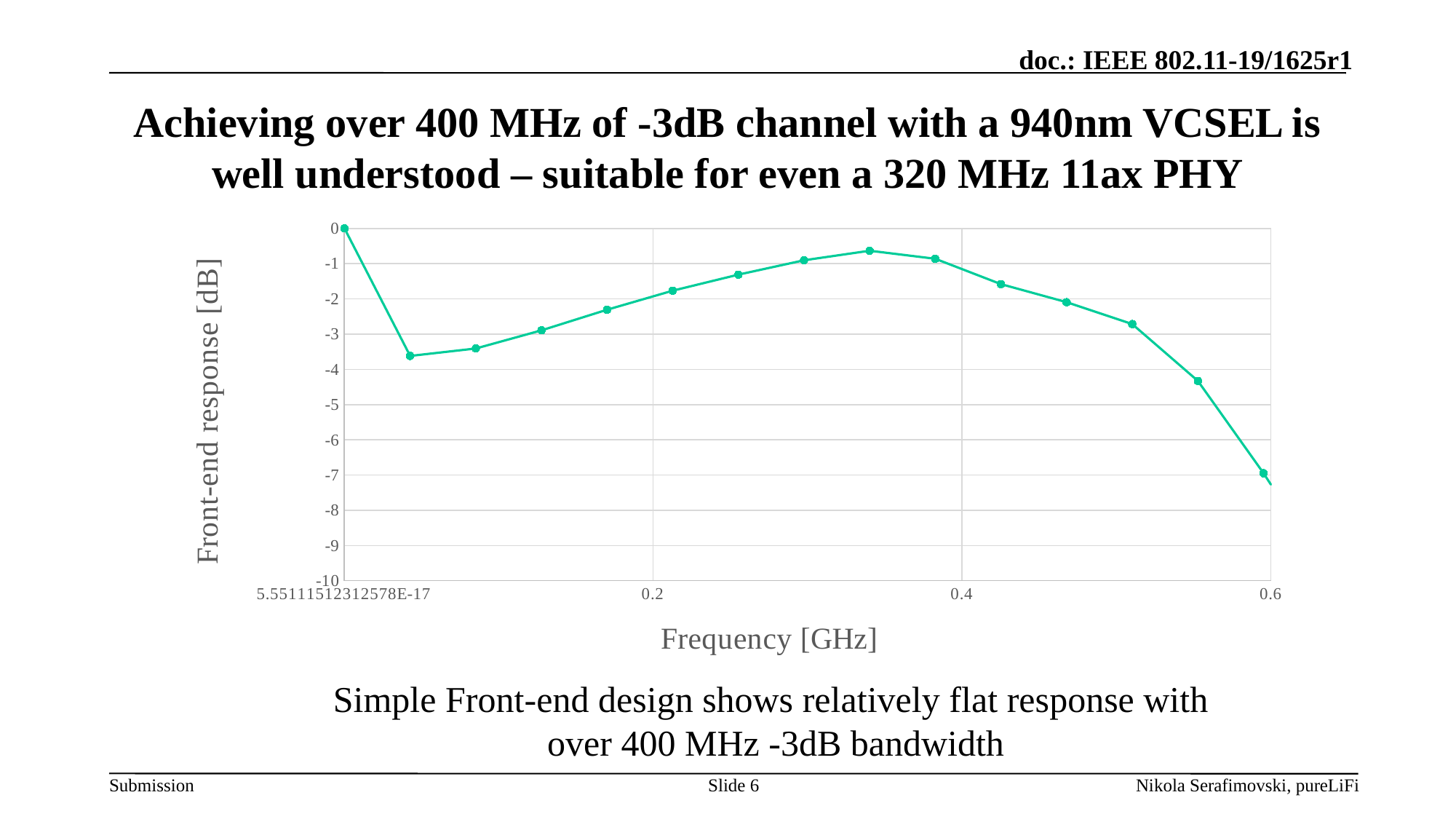
What is the title of the x axis of the chart? Frequency [GHz] Does the front-end response rise or fall as frequency increases from about 0.05 GHz to about 0.35 GHz? rise Does the front-end response rise or fall as frequency increases from 0.4 GHz to 0.6 GHz? fall Is the value of the data point just after 0 GHz (the first dip) greater or less than -3? less What is the front-end response value at the first data point (0 GHz)? 0 Which is larger: the response at the last data point near 0.6 GHz or the response at the point near 0.2 GHz? the point near 0.2 GHz How many data points are plotted on the line? 15 What kind of chart is shown on the slide? line chart Is the value of the local peak between 0.2 and 0.4 GHz greater or less than -1? greater Is the lowest value on the line greater or less than -6? less At which frequency does the line reach its highest value? 0 GHz (the first point) What is the title of the y axis of the chart? Front-end response [dB]